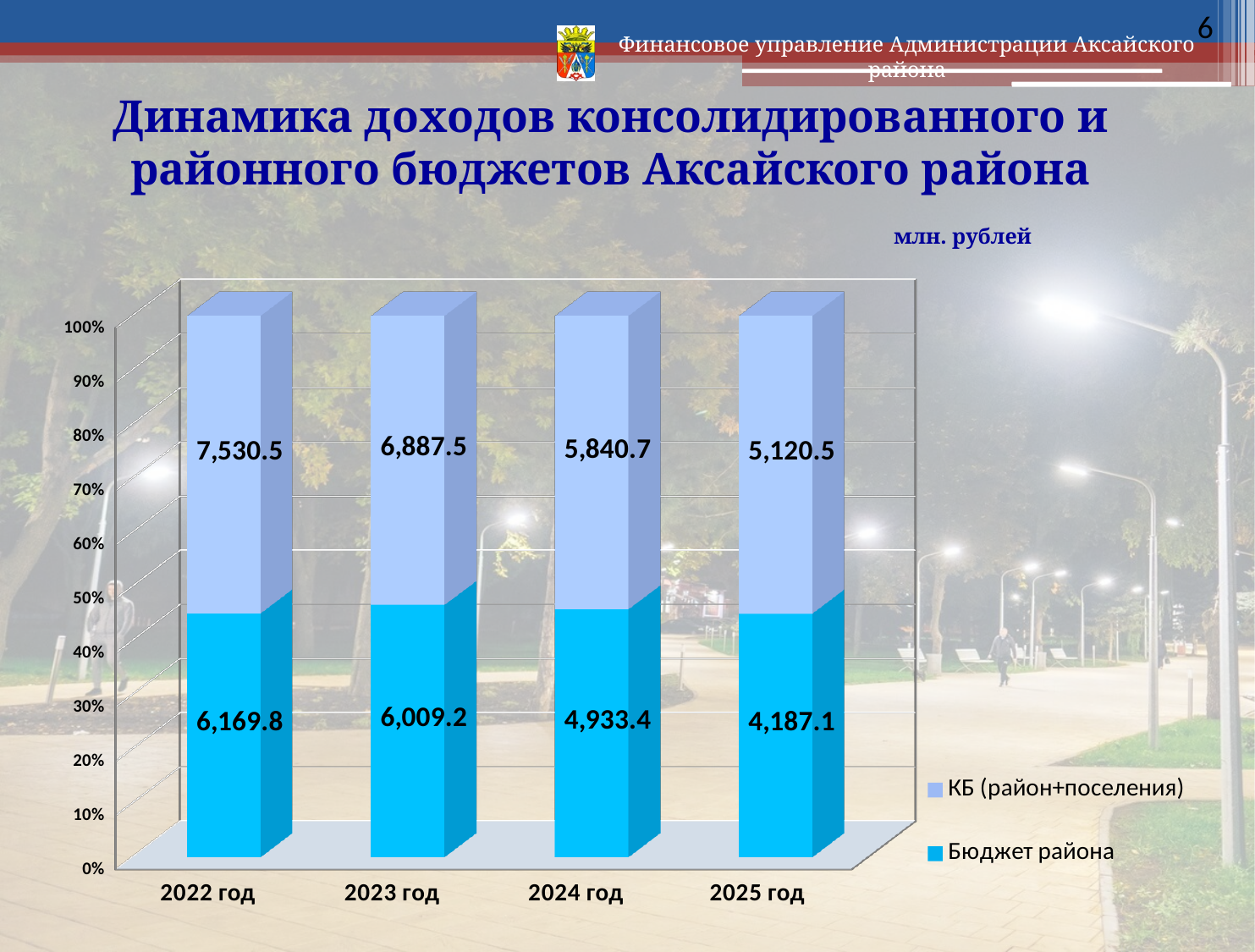
In which year is the value for Бюджет района the lowest? 2025 год What is the difference between КБ (район+поселения) and Бюджет района in 2022 год? 1,360.7 Which is larger: Бюджет района in 2023 год or КБ (район+поселения) in 2024 год? Бюджет района in 2023 год What is the value for Бюджет района in 2025 год? 4,187.1 What is the value for КБ (район+поселения) in 2024 год? 5,840.7 In which year is the value for КБ (район+поселения) the highest? 2022 год What is the value for КБ (район+поселения) in 2022 год? 7,530.5 By how much does the value for Бюджет района in 2022 год exceed the value in 2025 год? 1,982.7 How many years are shown on the x axis? 4 What is the value for Бюджет района in 2023 год? 6,009.2 How many series does the legend list? 2 Do the values for КБ (район+поселения) rise or fall from 2022 год to 2025 год? fall